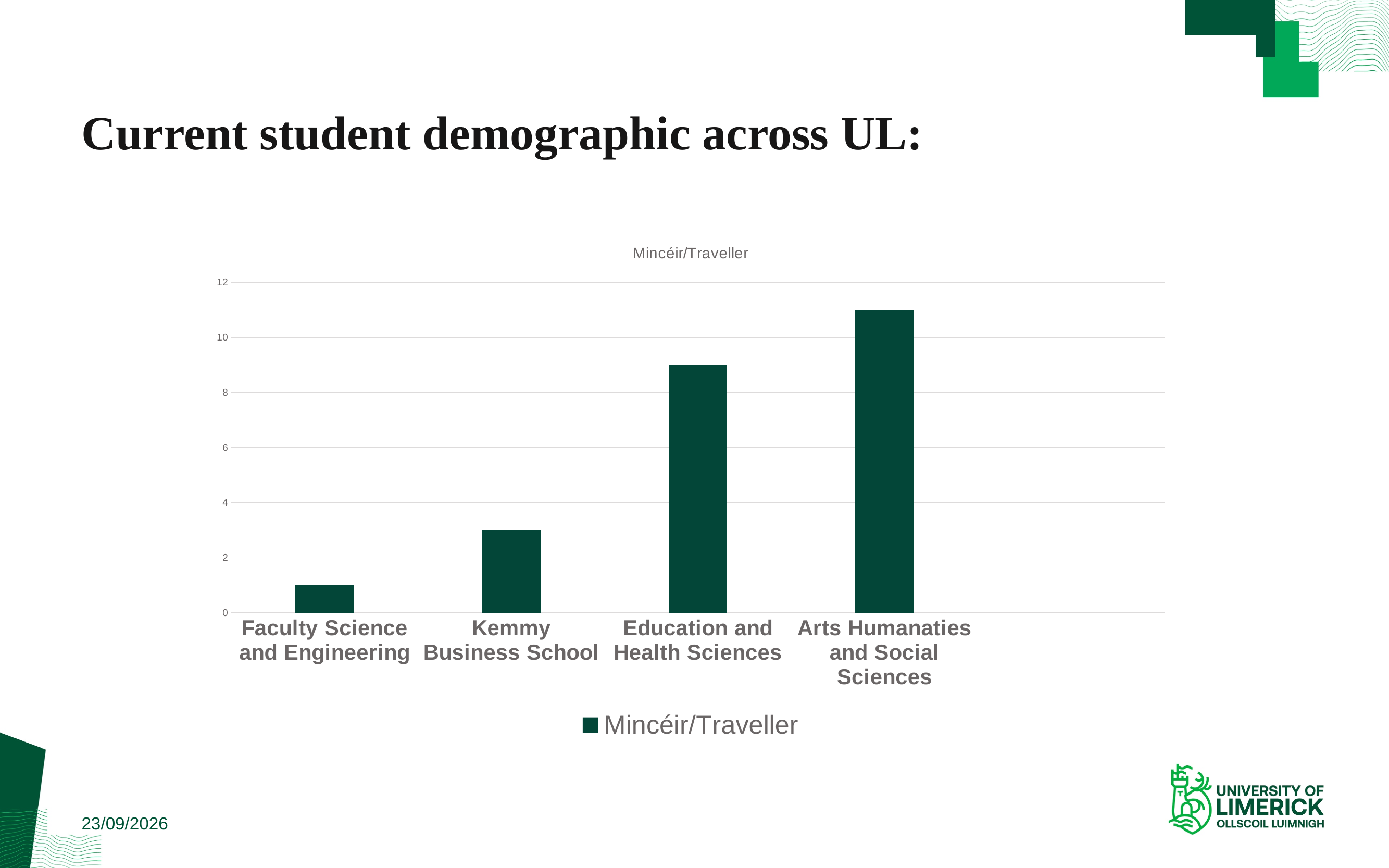
What kind of chart is shown on the slide? bar chart How many faculties are shown on the x axis of the chart? 4 Which is larger, the value for Kemmy Business School or the value for Education and Health Sciences? Education and Health Sciences Is the value for Arts Humanaties and Social Sciences greater or less than 10? greater Is the value for Kemmy Business School greater or less than 4? less Which faculty has the lowest value in the Mincéir/Traveller chart? Faculty Science and Engineering Is the value for Education and Health Sciences greater or less than 8? greater What is the title of the chart? Mincéir/Traveller Do the values rise or fall from left to right across the faculties? rise Which faculty has the highest value in the Mincéir/Traveller chart? Arts Humanaties and Social Sciences How many series does the legend list? 1